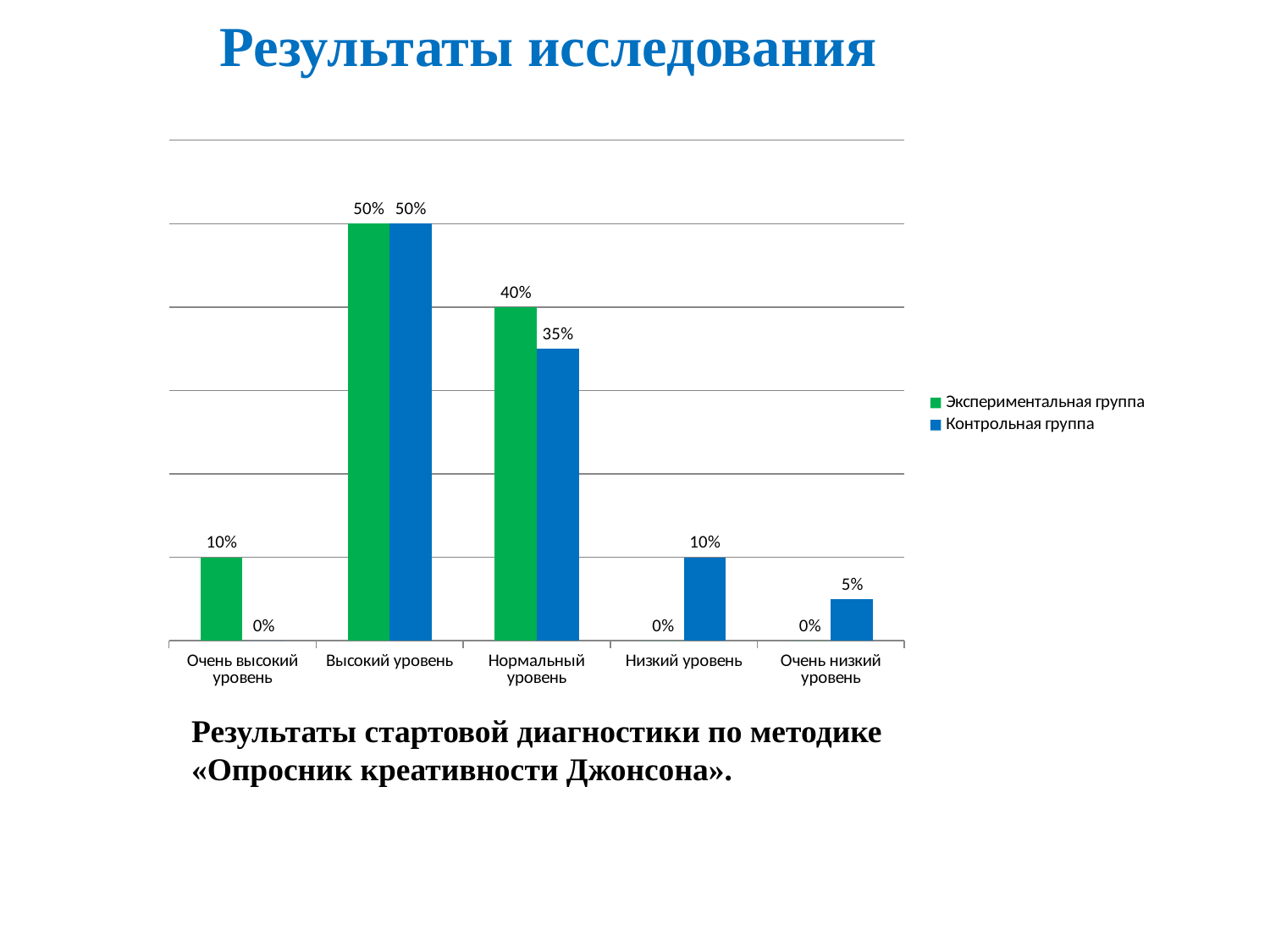
What is the value for Экспериментальная группа at Очень высокий уровень? 10% What kind of chart is shown on the slide? Bar chart What is the value for Контрольная группа at Очень низкий уровень? 5% Which is larger at Очень высокий уровень: Экспериментальная группа or Контрольная группа? Экспериментальная группа Which category has the highest value for Контрольная группа? Высокий уровень How many series does the legend list? 2 How many categories are shown on the x axis? 5 What is the difference between Экспериментальная группа and Контрольная группа at Нормальный уровень? 5% What is the difference between Контрольная группа at Низкий уровень and at Очень низкий уровень? 5% What is the value for Контрольная группа at Нормальный уровень? 35% What is the value for Экспериментальная группа at Низкий уровень? 0% Which colour represents Контрольная группа in the chart? Blue